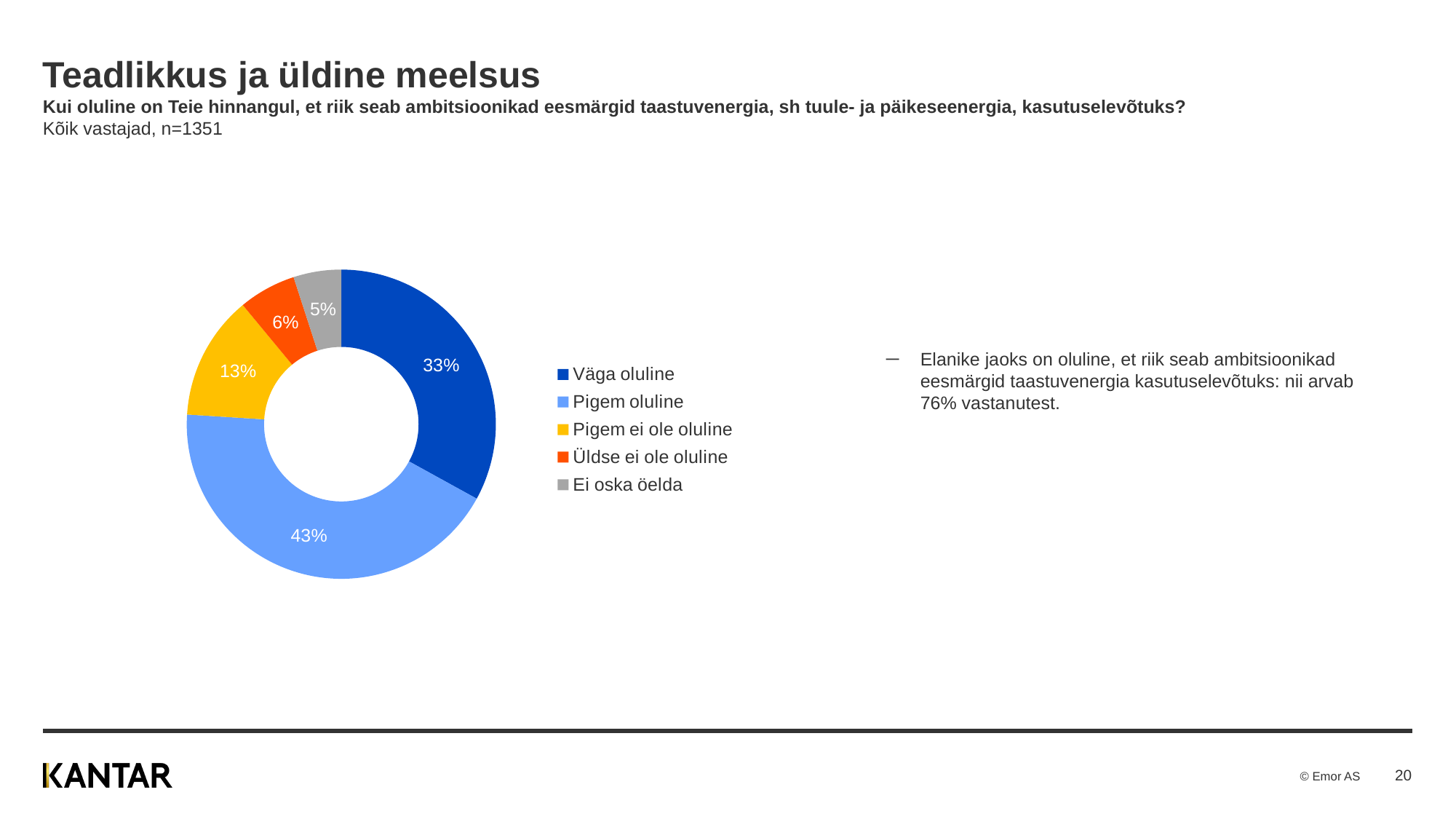
What share of respondents answered "Üldse ei ole oluline"? 6% What share of respondents answered "Väga oluline"? 33% What share of respondents answered "Pigem oluline"? 43% What share of respondents answered "Ei oska öelda"? 5% Which is larger, the share for "Pigem ei ole oluline" or for "Üldse ei ole oluline"? Pigem ei ole oluline What share of respondents answered "Pigem ei ole oluline"? 13% What colour is the "Pigem ei ole oluline" slice? Yellow What kind of chart is shown on the slide? Doughnut (pie) chart What is the difference in percentage points between "Pigem oluline" and "Väga oluline"? 10 Which response category has the smallest share? Ei oska öelda Which response category has the largest share? Pigem oluline How many response categories are shown in the chart? 5